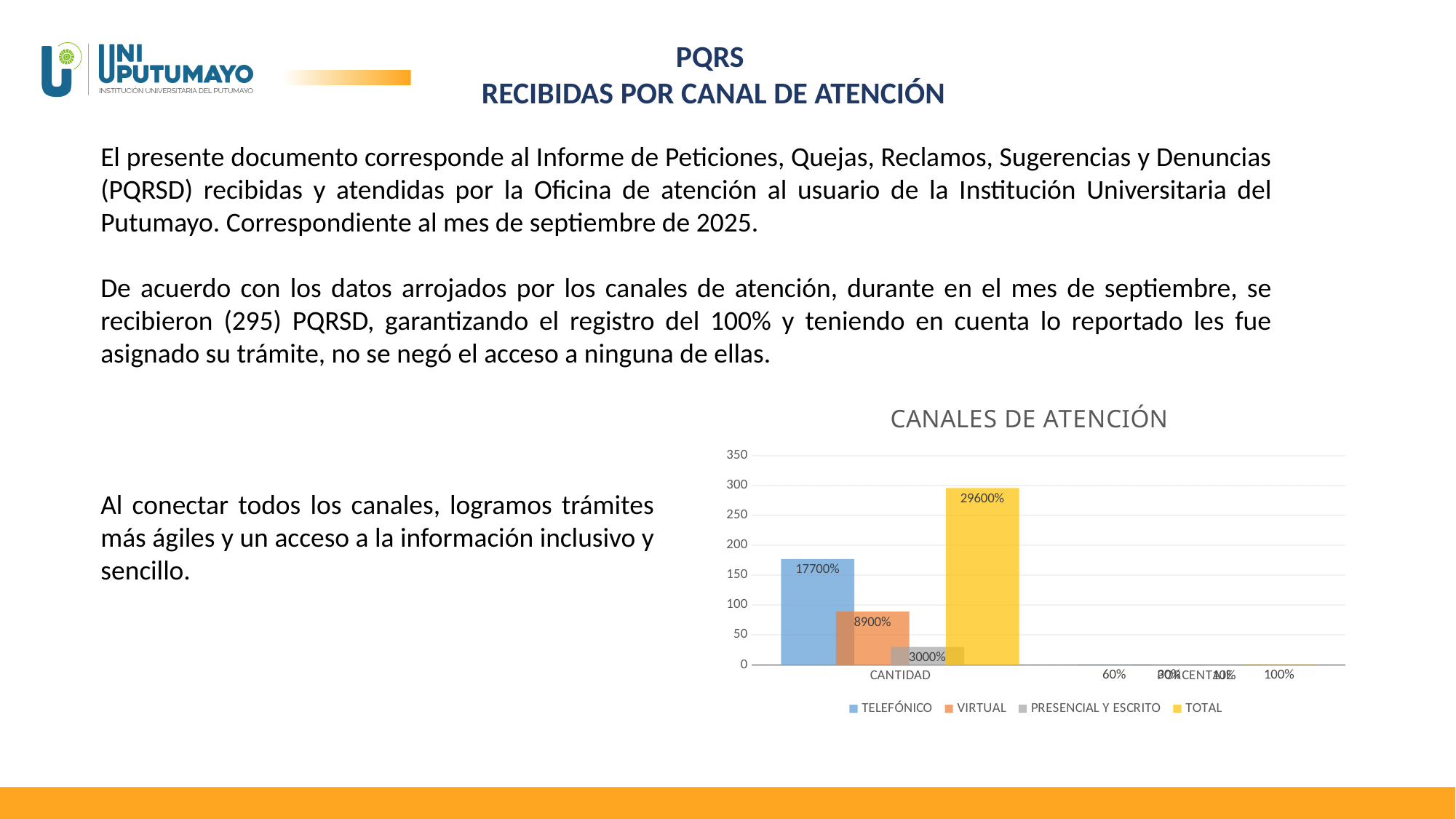
What is the data label on the TOTAL bar in the CANTIDAD group? 29600% What is the data label on the TELEFÓNICO bar in the CANTIDAD group? 17700% What is the title of the chart? CANALES DE ATENCIÓN In the CANTIDAD group, which bar is taller: TELEFÓNICO or VIRTUAL? TELEFÓNICO Is the TOTAL bar in the CANTIDAD group greater or less than 250 on the vertical axis? greater How many series does the chart legend list? 4 What colour is the TOTAL series in the chart? yellow What kind of chart is shown on the slide? bar chart Which series has the shortest bar in the CANTIDAD group? PRESENCIAL Y ESCRITO Which series has the tallest bar in the CANTIDAD group? TOTAL What is the data label on the PRESENCIAL Y ESCRITO bar in the CANTIDAD group? 3000% What is the data label on the VIRTUAL bar in the CANTIDAD group? 8900%